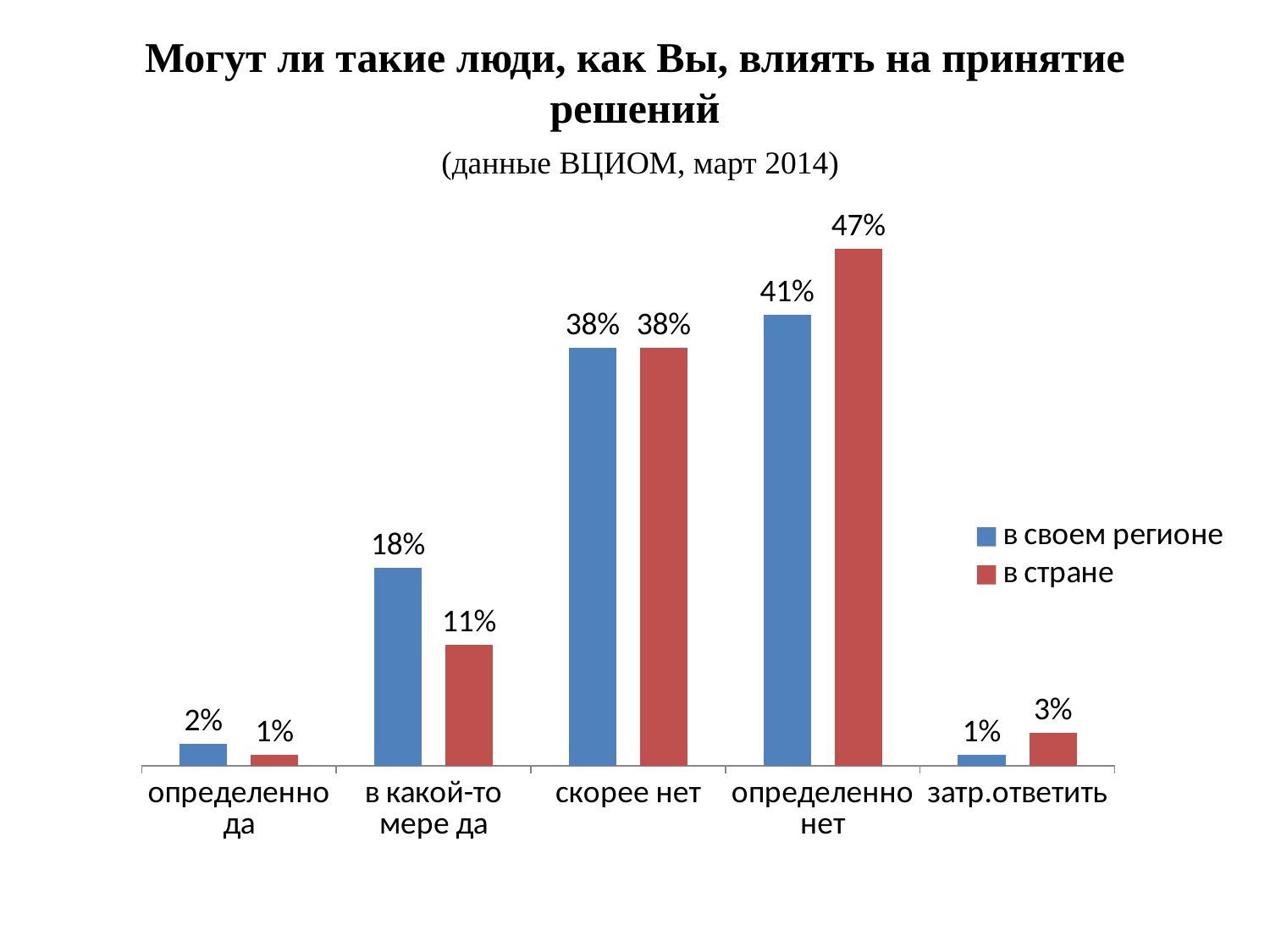
Which series is shown in red? в стране What is the value for "определенно нет" in the "в стране" series? 47% What is the difference between the "в стране" and "в своем регионе" values for "определенно нет"? 6% What kind of chart is shown on the slide? bar chart What is the difference between the "в своем регионе" and "в стране" values for "в какой-то мере да"? 7% Which category has the highest value in the "в своем регионе" series? определенно нет How many series does the legend list? 2 What is the value for "в какой-то мере да" in the "в своем регионе" series? 18% How many categories are shown on the x axis? 5 Which category has the lowest value in the "в стране" series? определенно да Which is larger for "определенно да": the "в своем регионе" value or the "в стране" value? в своем регионе What is the value for "затр.ответить" in the "в стране" series? 3%